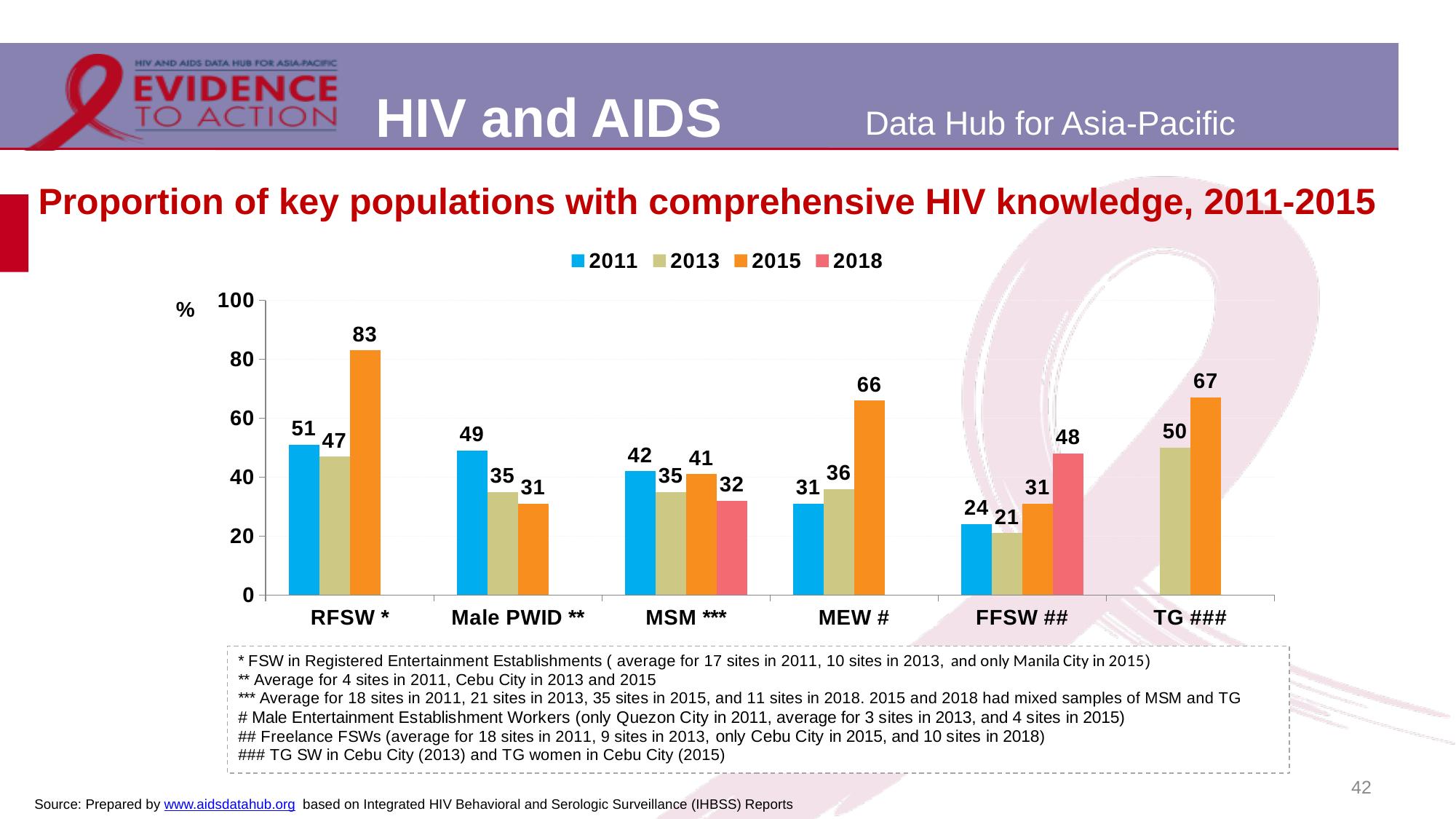
What is the 2013 value for TG ###? 50 Which category has the lowest 2013 value? FFSW ## What is the 2015 value for RFSW *? 83 What is the 2011 value for Male PWID **? 49 Which categories have a 2018 bar? MSM *** and FFSW ## How many categories are shown on the x axis? 6 Which is larger, the 2015 value for MSM *** or the 2015 value for Male PWID **? MSM *** How many series does the legend list? 4 What is the 2018 value for FFSW ##? 48 What is the difference between the 2015 and 2011 values for MEW #? 35 What kind of chart is shown on the slide? Bar chart Which category has the highest 2015 value? RFSW *